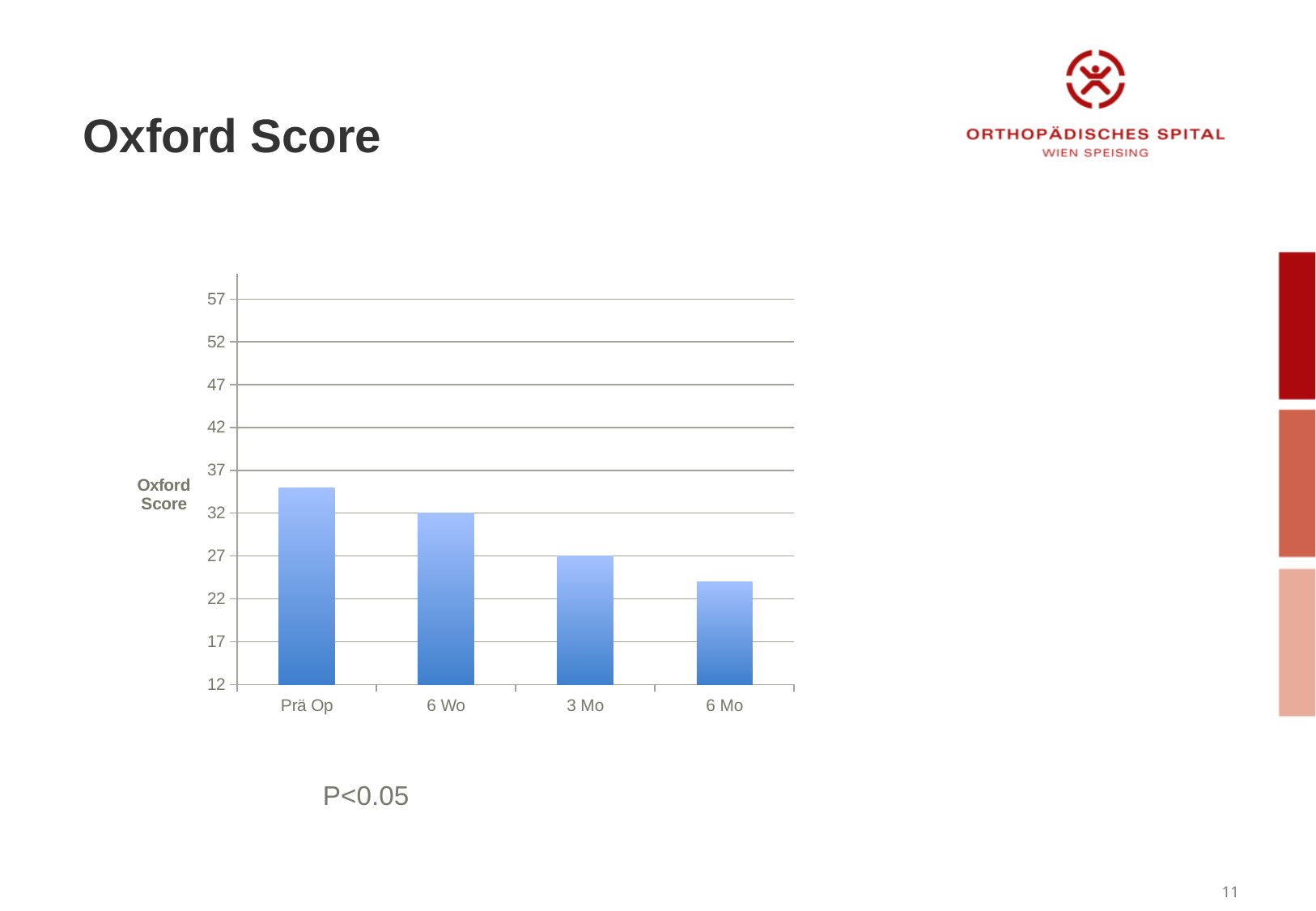
What is the Oxford Score value for 6 Wo? 32 What is the Oxford Score value for 3 Mo? 27 What is the label on the vertical axis of the chart? Oxford Score How many categories are plotted on the x axis? 4 What is the difference between the values for 6 Wo and 3 Mo? 5 What kind of chart is shown on the slide? bar chart Is the value for 6 Mo greater or less than 27? less Is the value for Prä Op greater or less than 32? greater Do the values rise or fall from Prä Op to 6 Mo? fall Which category has the highest Oxford Score? Prä Op Which is larger, the value for 6 Wo or the value for 6 Mo? 6 Wo Which category has the lowest Oxford Score? 6 Mo